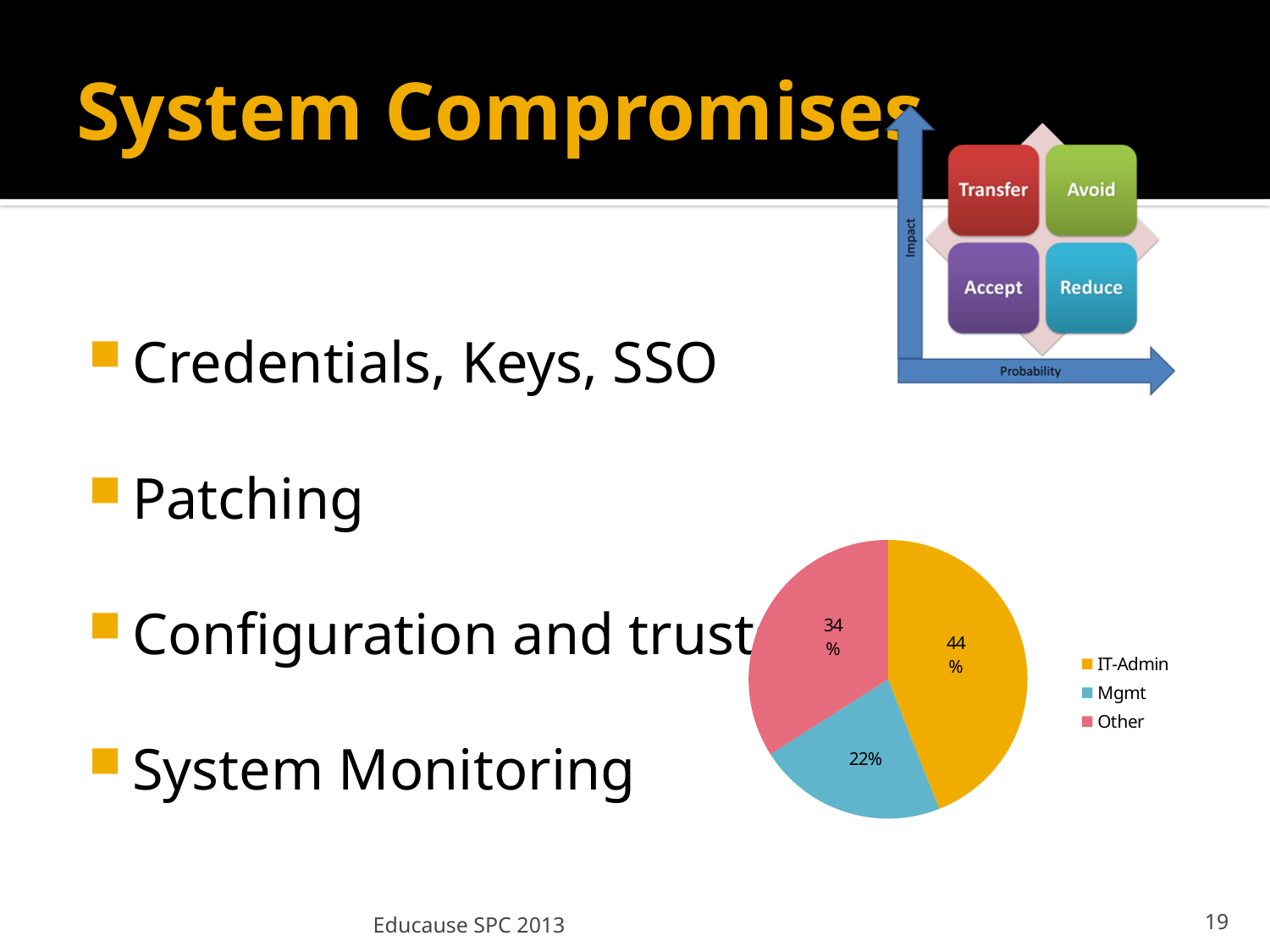
Which category has the smallest slice in the pie chart? Mgmt How many entries does the pie chart's legend list? 3 How many slices does the pie chart have? 3 What is the difference in percentage points between the IT-Admin and Other slices? 10 Which slice is larger, Other or Mgmt? Other Which category has the largest slice in the pie chart? IT-Admin What share of the pie chart does IT-Admin account for? 44% What share of the pie chart does Other account for? 34% What kind of chart is shown at the bottom right of the slide? Pie chart What colour is the IT-Admin slice in the pie chart? Yellow What share of the pie chart does Mgmt account for? 22% What is the difference in percentage points between the IT-Admin and Mgmt slices? 22